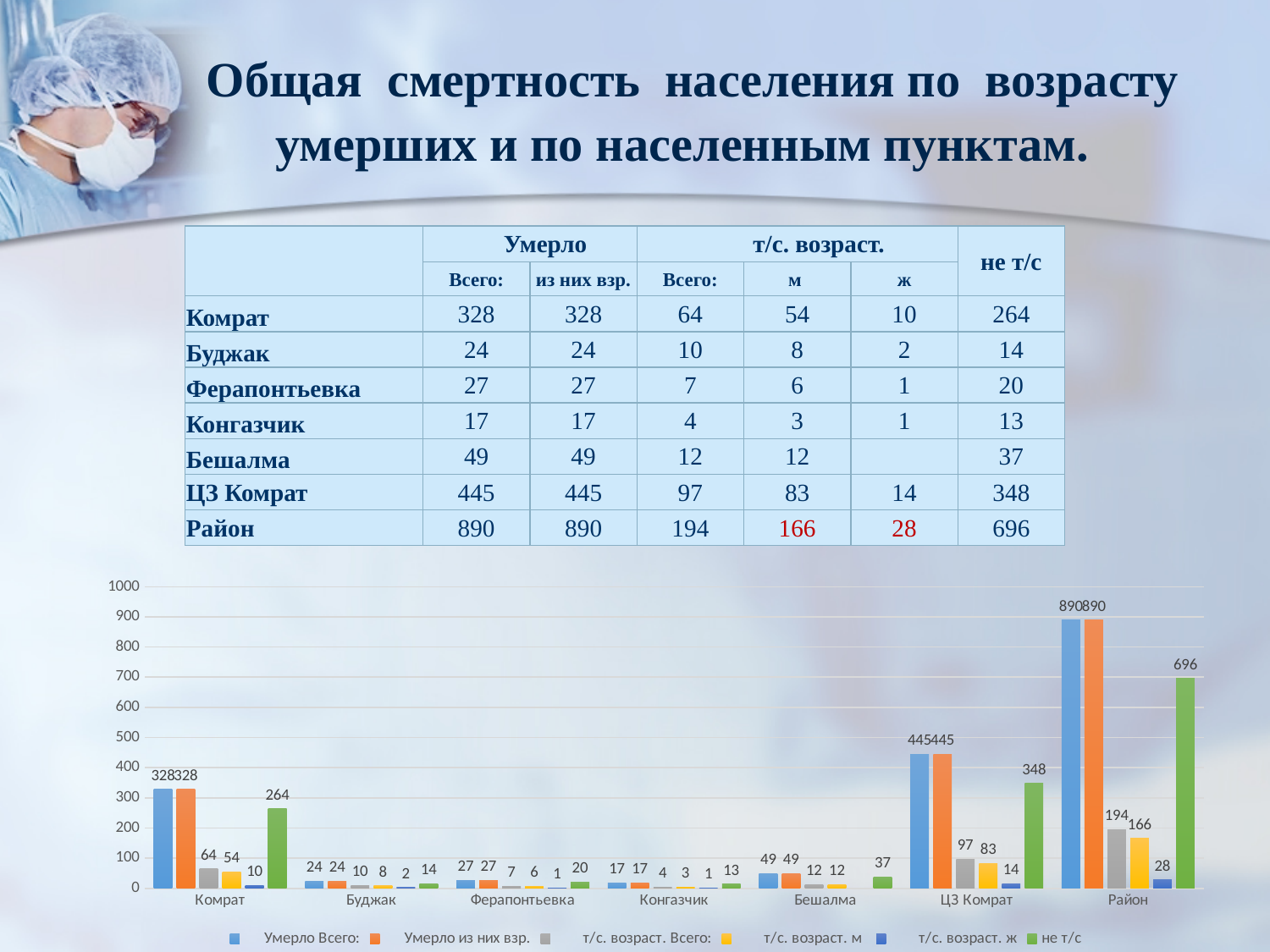
What is the value of 'т/с. возраст. м' for Комрат in the chart? 54 Which is larger in the chart: the 'не т/с' value for Комрат or for Бешалма? Комрат How many series does the chart legend list? 6 How many categories (settlements) are shown on the x axis of the chart? 7 What is the difference between 'Умерло Всего' and 'не т/с' for Комрат in the chart? 64 What kind of chart is shown at the bottom of the slide? bar chart What is the value of 'т/с. возраст. Всего' for ЦЗ Комрат in the chart? 97 What colour are the bars for the 'не т/с' series in the chart? green What is the value of 'не т/с' for Район in the chart? 696 Which category has the highest value for 'Умерло Всего' in the chart? Район Which category has the lowest value for 'Умерло Всего' in the chart? Конгазчик What is the difference between the 'не т/с' values for Район and ЦЗ Комрат in the chart? 348